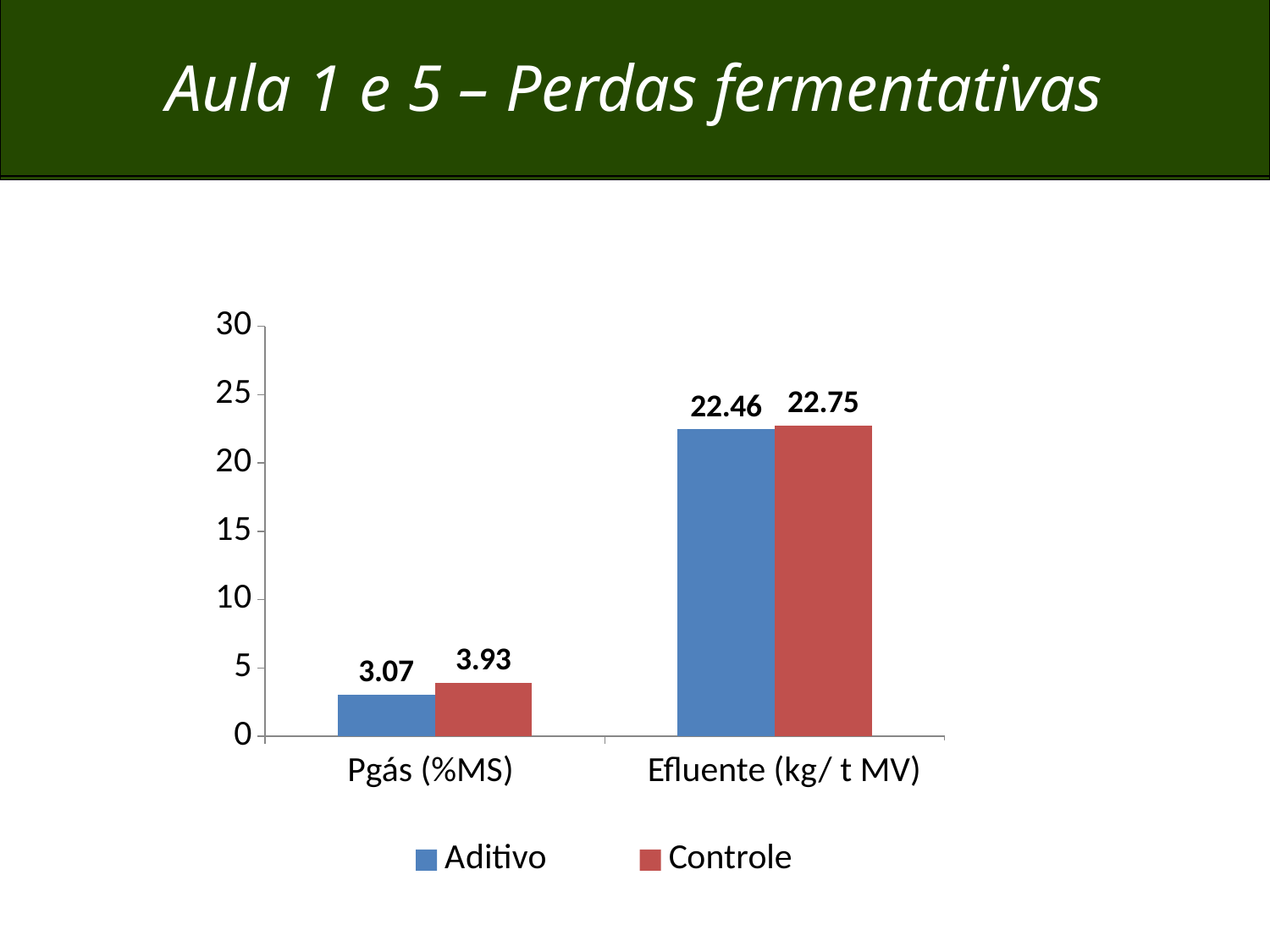
What is the Controle value for Efluente (kg/ t MV)? 22.75 What kind of chart is shown on the slide? Bar chart How many series does the legend list? 2 Which category has the highest Controle value? Efluente (kg/ t MV) What is the difference between the Controle and Aditivo values for Efluente (kg/ t MV)? 0.29 What is the Controle value for Pgás (%MS)? 3.93 For Pgás (%MS), which series has the larger value, Aditivo or Controle? Controle What is the Aditivo value for Efluente (kg/ t MV)? 22.46 Which category has the lowest Aditivo value? Pgás (%MS) What is the difference between the Controle and Aditivo values for Pgás (%MS)? 0.86 What is the Aditivo value for Pgás (%MS)? 3.07 How many categories are shown on the x axis? 2